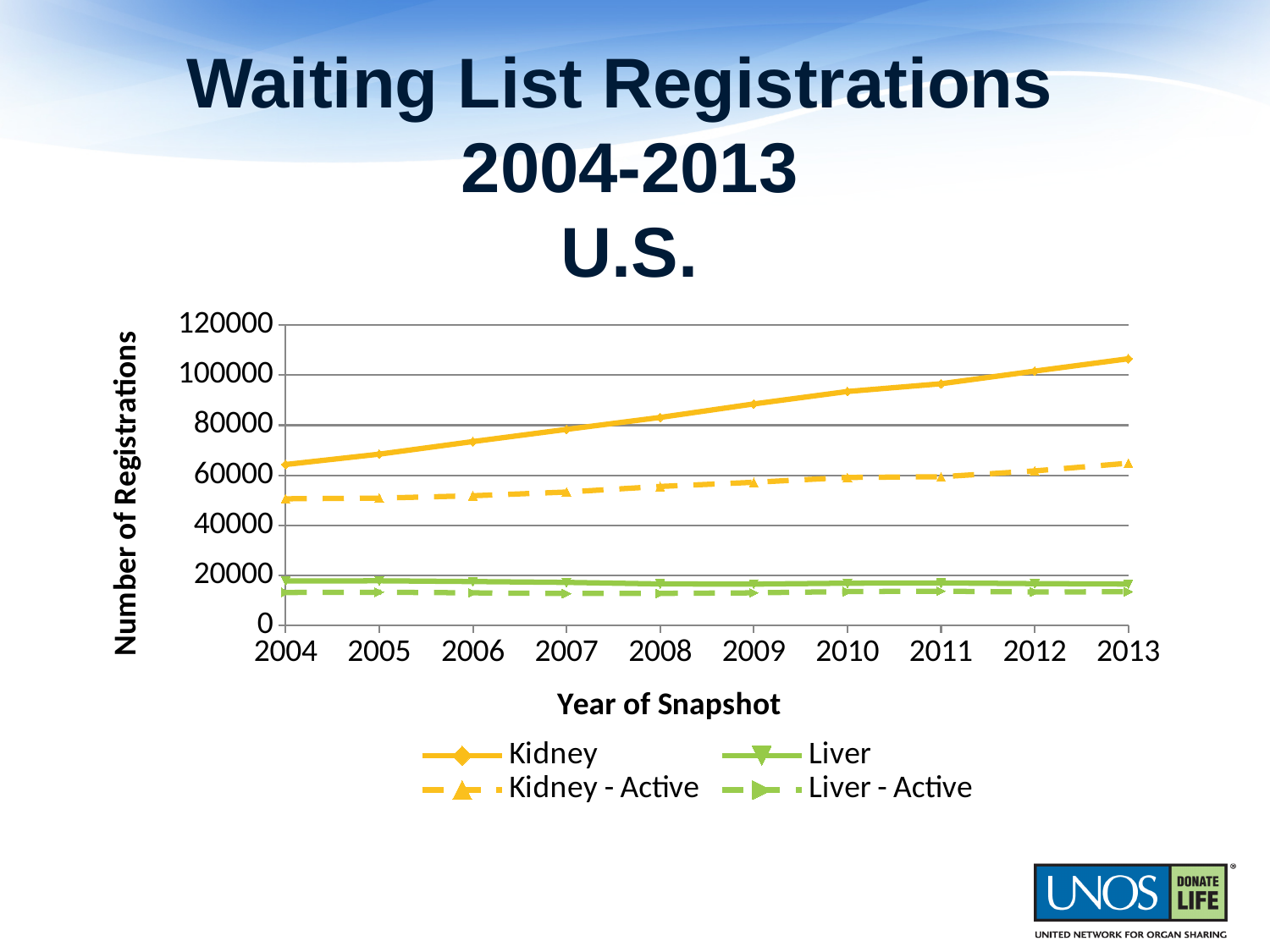
Which series has the lowest value in 2013? Liver - Active Which series has the highest value in 2013? Kidney Is the value for Kidney in 2004 greater or less than 80000? less How many series does the legend list? 4 Does the Kidney series rise or fall from 2004 to 2013? Rises Is the value for Liver in 2013 greater or less than 20000? less How many years are plotted along the x axis? 10 Does the Kidney - Active series rise or fall from 2004 to 2013? Rises What is the title of the x axis? Year of Snapshot Is the value for Kidney in 2013 greater or less than 100000? greater What kind of chart is shown on the slide? Line chart